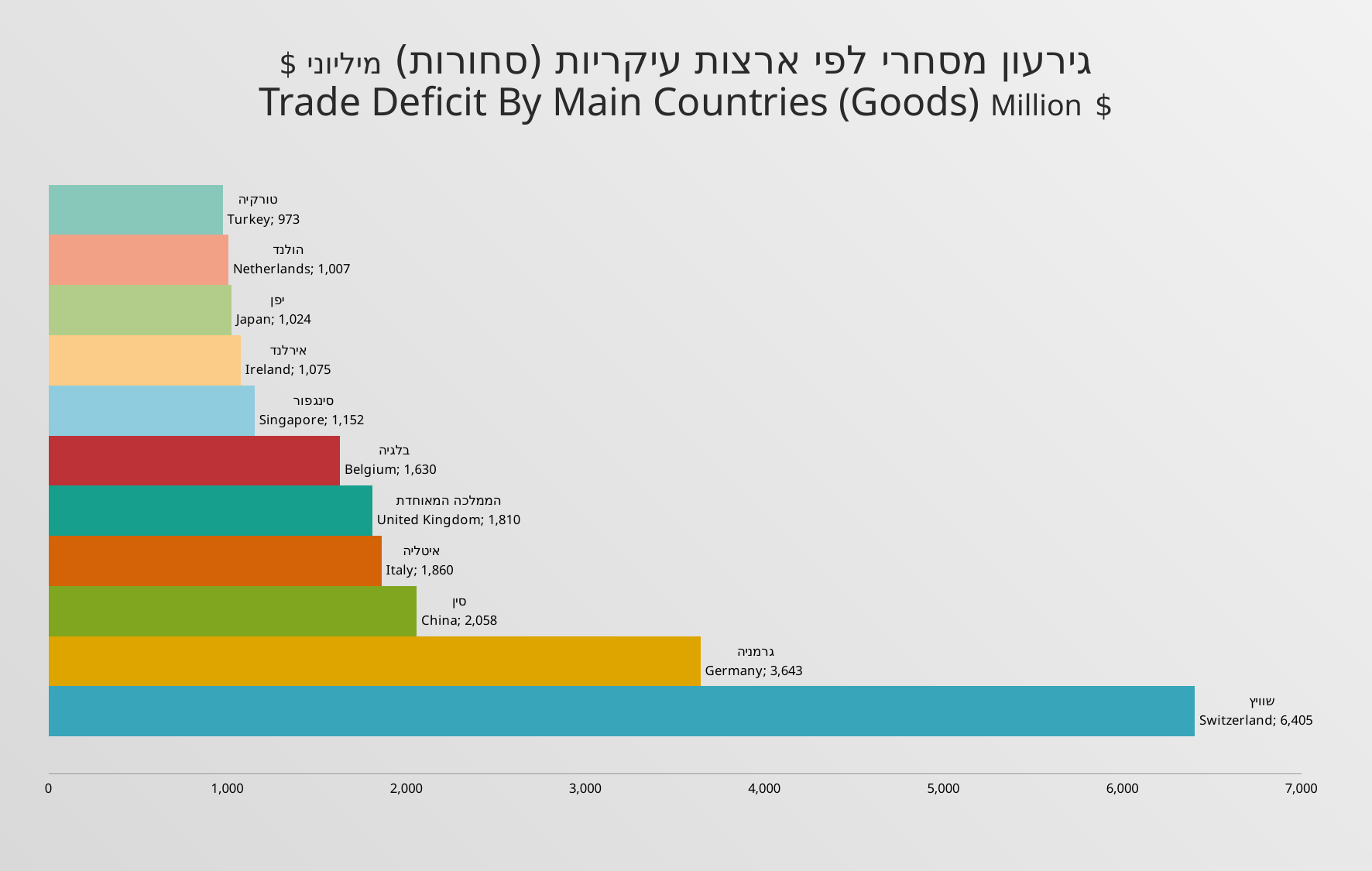
What kind of chart is shown on the slide? Bar chart What is the English title of the chart? Trade Deficit By Main Countries (Goods) Million $ How many countries are shown on the chart? 11 Is the value for Germany greater or less than 3,000? greater What is the difference between the values for Switzerland and Germany? 2,762 Which country has the lowest trade deficit on the chart? Turkey What is the trade deficit value shown for Germany? 3,643 What is the trade deficit value shown for Singapore? 1,152 What is the trade deficit value shown for the United Kingdom? 1,810 Which has a larger trade deficit, Belgium or Japan? Belgium Which country has the highest trade deficit on the chart? Switzerland What is the difference between the values for China and Italy? 198